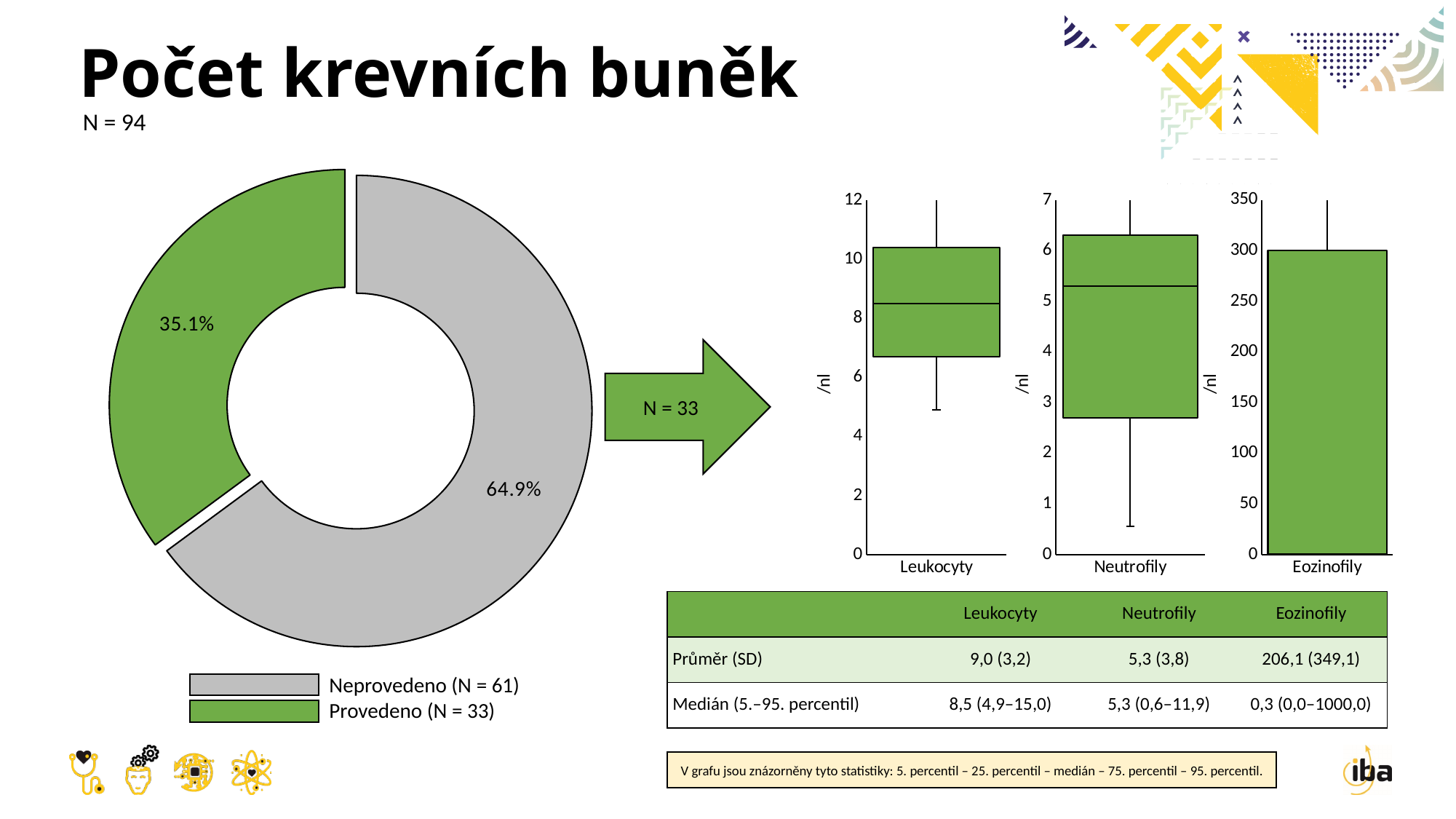
What kind of chart is the chart on the left of the slide? Donut (pie) chart On the donut chart, what percentage is shown for the Neprovedeno slice? 64.9% How many box plots are shown on the right side of the slide? 3 What kind of charts are the three charts on the right of the slide? Box plots On the donut chart, which slice is larger, Neprovedeno or Provedeno? Neprovedeno On the donut chart, what percentage is shown for the Provedeno slice? 35.1% According to the legend of the donut chart, how many cases are in the Provedeno group? N = 33 On the donut chart, what is the difference in percentage points between the Neprovedeno and Provedeno slices? 29.8 In the Leukocyty box plot, is the bottom of the box greater or less than 6? greater In the Neutrofily box plot, is the bottom of the box greater or less than 3? less In the Neutrofily box plot, is the top of the box greater or less than 6? greater How many slices does the donut chart have? 2